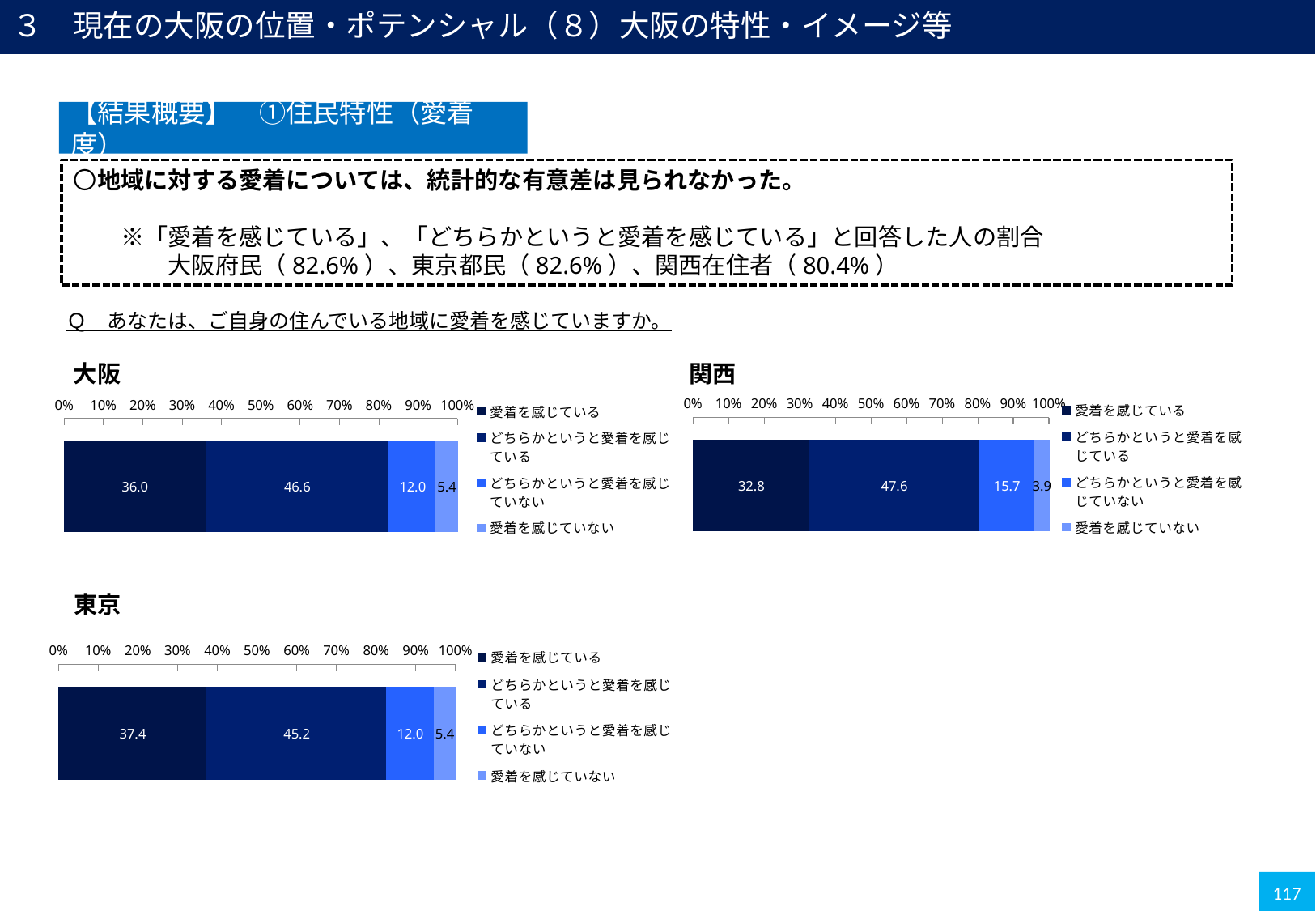
In the 東京 chart, what is the difference between 愛着を感じている and どちらかというと愛着を感じている? 7.8 What is the total of the stacked bar in the 関西 chart? 100.0 How many charts are shown on the slide? 3 In the 関西 chart, what is the value for どちらかというと愛着を感じていない? 15.7 What kind of chart is the 東京 chart? Stacked bar chart In the 関西 chart, what is the value for どちらかというと愛着を感じている? 47.6 In the 東京 chart, what is the value for 愛着を感じていない? 5.4 In the 関西 chart, which segment has the smallest value? 愛着を感じていない How many series does the legend of the 大阪 chart list? 4 In the 大阪 chart, what is the value for 愛着を感じている? 36.0 In the 大阪 chart, which segment has the largest value? どちらかというと愛着を感じている Which is larger: 愛着を感じている in the 大阪 chart or 愛着を感じている in the 東京 chart? 東京